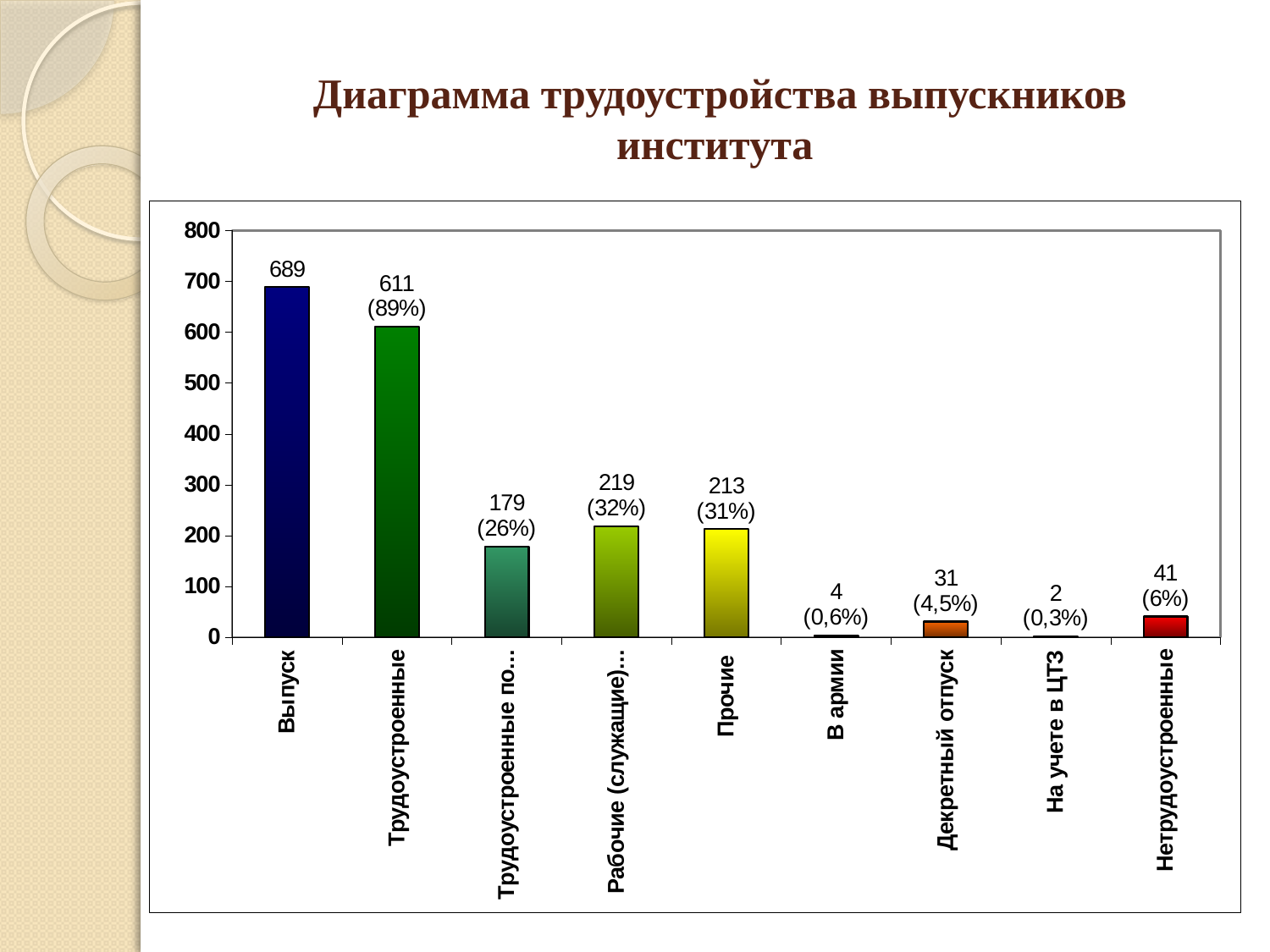
What is the value for Выпуск? 689 What kind of chart is shown on the slide? bar chart What is the difference between the values for Выпуск and Трудоустроенные? 78 How many categories are shown on the x axis? 9 What percentage is shown for В армии? 0,6% What is the value for Декретный отпуск? 31 Which category has the highest value? Выпуск Which category has the lowest value? На учете в ЦТЗ What is the value for Трудоустроенные? 611 Which is larger, the value for Декретный отпуск or the value for Нетрудоустроенные? Нетрудоустроенные What is the value for Нетрудоустроенные? 41 What percentage is shown for Трудоустроенные? 89%